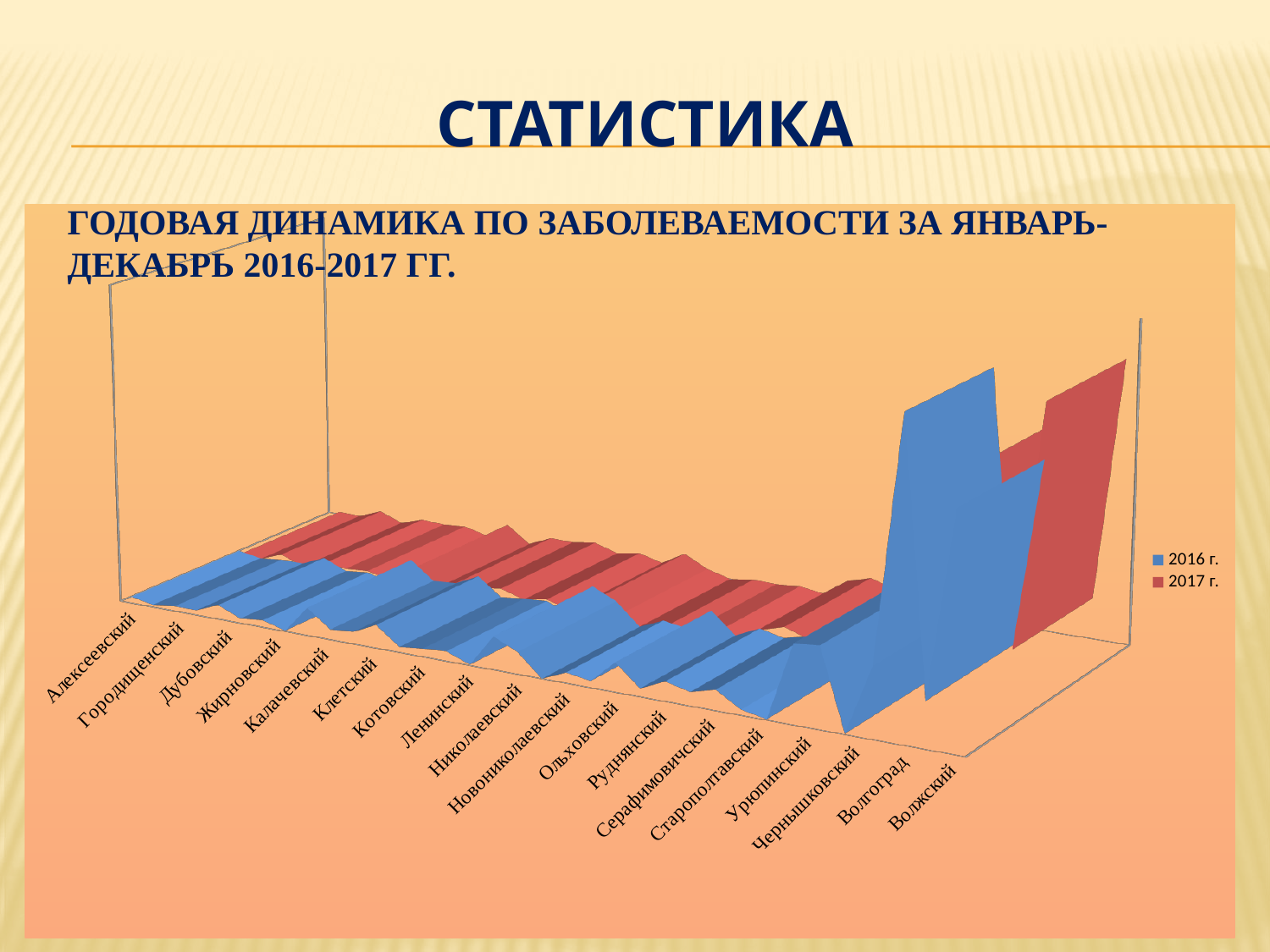
How many categories are labelled along the x axis? 18 Which category has the highest value for the 2017 г. series? Волжский Which colour represents the 2017 г. series? Red Which category has the highest value for the 2016 г. series? Волгоград How many series does the legend list? 2 What is the first category on the x axis? Алексеевский For the 2016 г. series, which is larger: Волгоград or Волжский? Волгоград What kind of chart is shown on the slide? Line chart (3D) For the 2017 г. series, which is larger: Волгоград or Алексеевский? Волгоград What are the two series listed in the legend? 2016 г. and 2017 г.